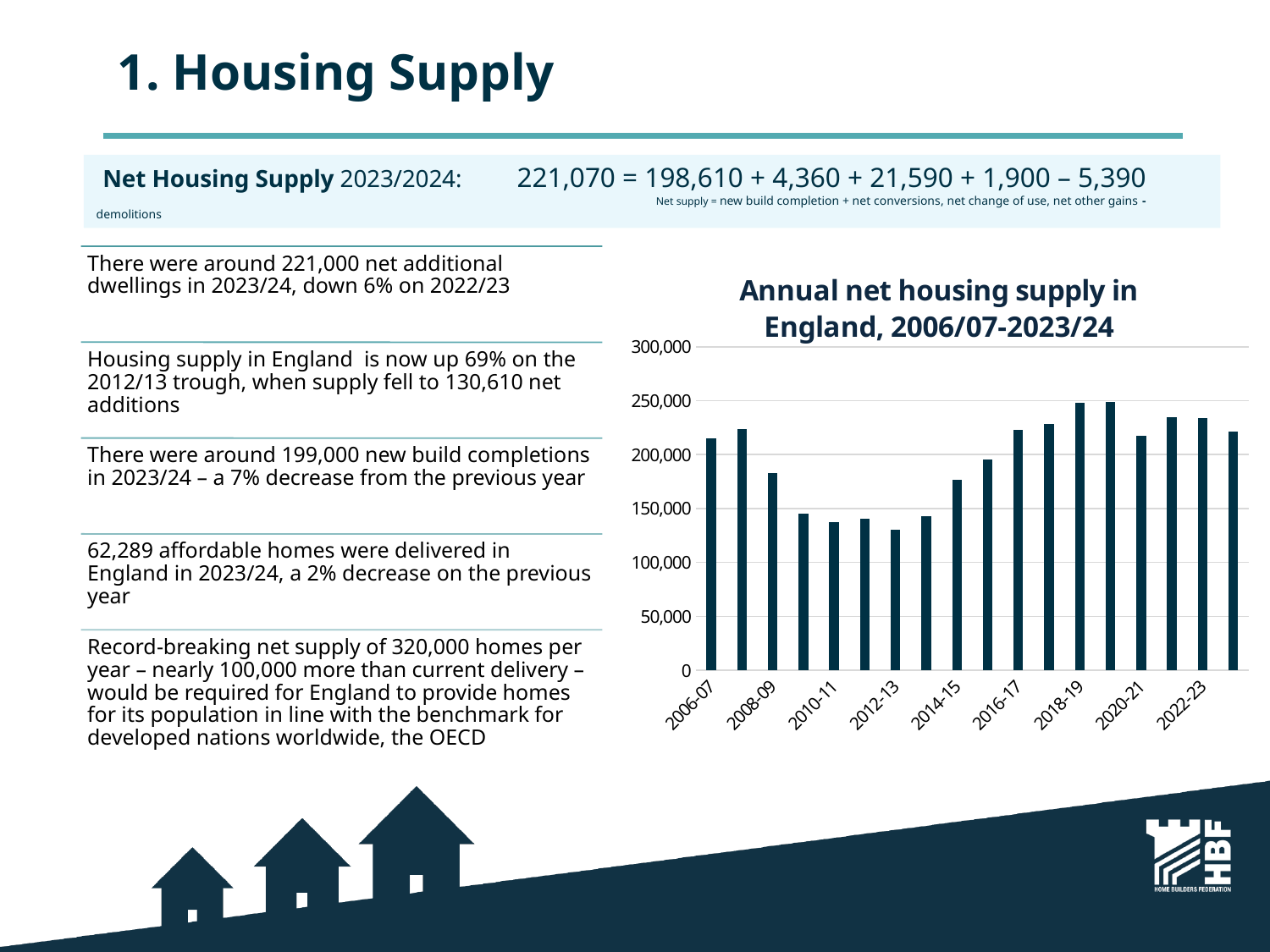
Which is larger, the value for 2006-07 or the value for 2008-09? 2006-07 What is the title of the chart? Annual net housing supply in England, 2006/07-2023/24 Is the value for 2008-09 greater or less than 200,000? less Which year has the lowest annual net housing supply in the chart? 2012-13 Is the value for 2006-07 greater or less than 200,000? greater Is the value for 2012-13 greater or less than 150,000? less Do the values rise or fall from 2012-13 to 2018-19? rise How many bars are plotted in the chart? 18 What kind of chart is shown on the slide? bar chart Which is larger, the value for 2012-13 or the value for 2016-17? 2016-17